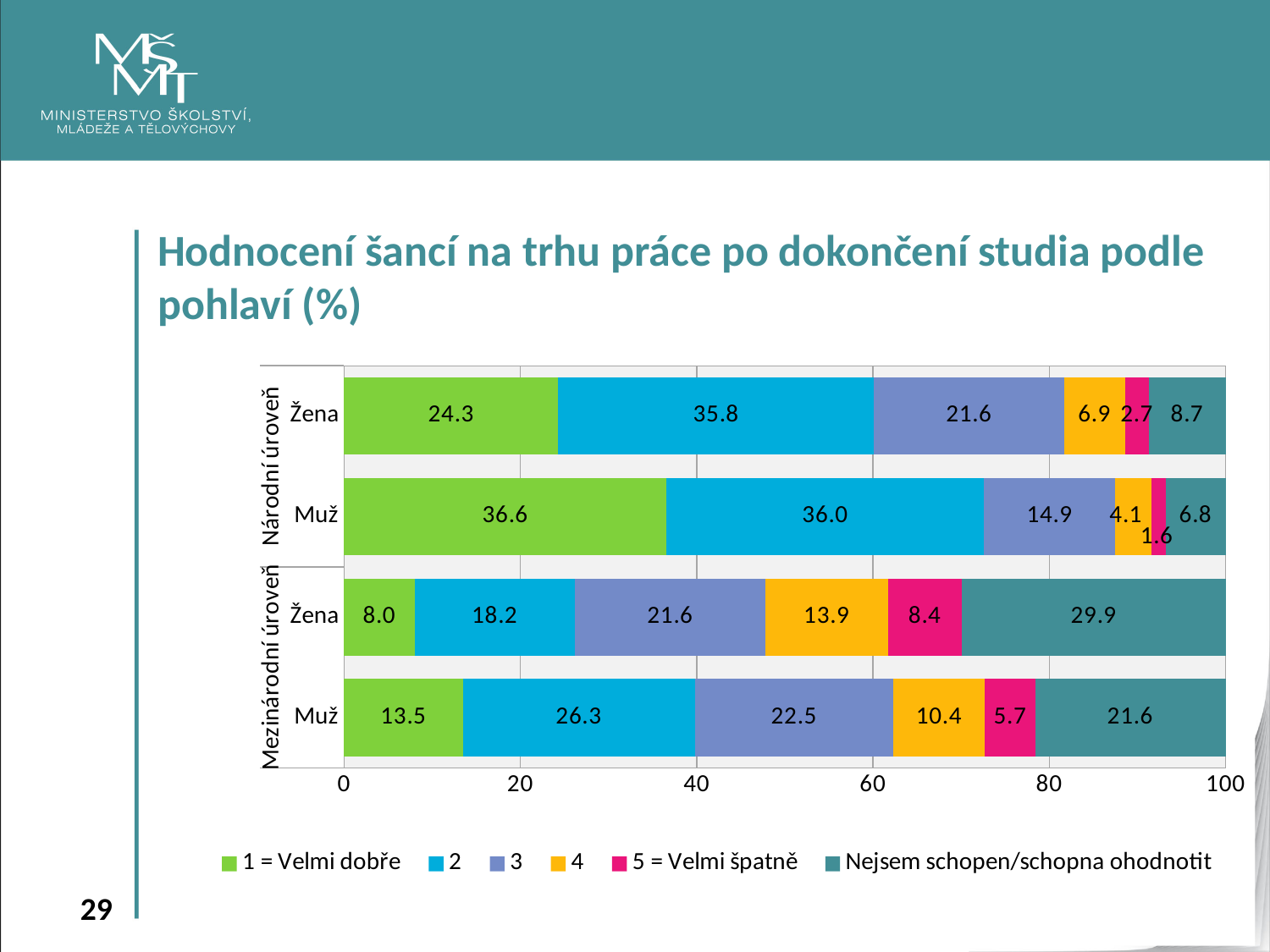
What is the value of "1 = Velmi dobře" for Muž at Národní úroveň? 36.6 What is the value of series "2" for Muž at Mezinárodní úroveň? 26.3 Which category has the highest value for "1 = Velmi dobře"? Muž (Národní úroveň) How many categories (bars) are shown in the chart? 4 What kind of chart is shown on the slide? Stacked bar chart What is the value of "Nejsem schopen/schopna ohodnotit" for Žena at Mezinárodní úroveň? 29.9 What is the difference between the "1 = Velmi dobře" values for Muž and Žena at Národní úroveň? 12.3 Which is larger: the value of series "4" for Žena at Mezinárodní úroveň or for Muž at Mezinárodní úroveň? Žena (Mezinárodní úroveň) What is the value of "5 = Velmi špatně" for Žena at Národní úroveň? 2.7 How many series does the legend list? 6 Which category has the lowest value for "Nejsem schopen/schopna ohodnotit"? Muž (Národní úroveň) What is the title of the chart on the slide? Hodnocení šancí na trhu práce po dokončení studia podle pohlaví (%)